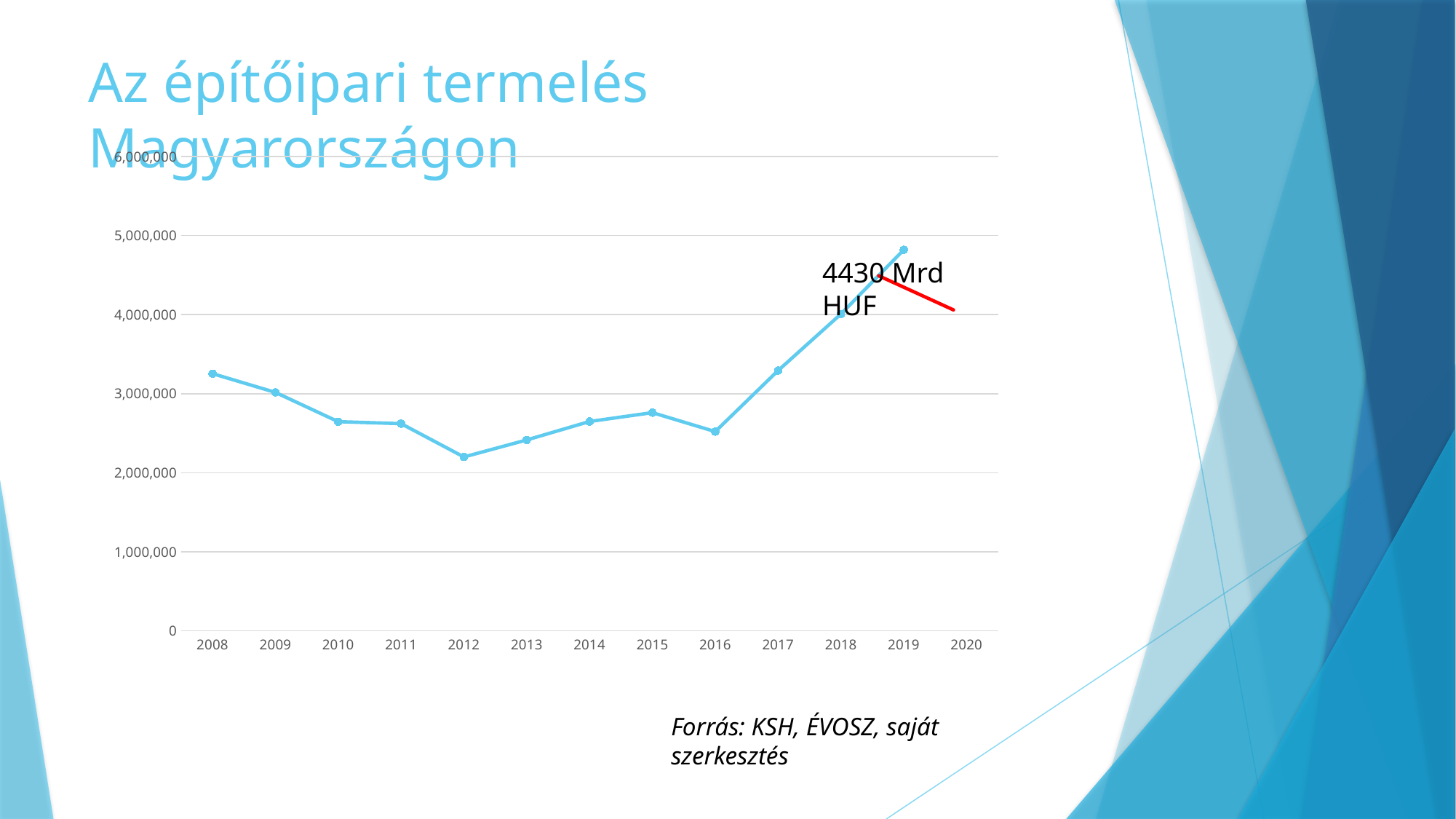
Which year has the lowest value on the chart? 2012 Which year has the highest value on the chart? 2019 Do the values rise or fall from 2008 to 2012? fall Which year has the larger value, 2008 or 2016? 2008 How many data points are plotted on the line? 12 Is the value for 2008 greater or less than 3,000,000? greater What kind of chart is shown on the slide? line chart Is the value for 2017 greater or less than 3,000,000? greater Do the values rise or fall from 2016 to 2019? rise Is the value for 2019 greater or less than 4,000,000? greater What is the title of the slide containing the chart? Az építőipari termelés Magyarországon